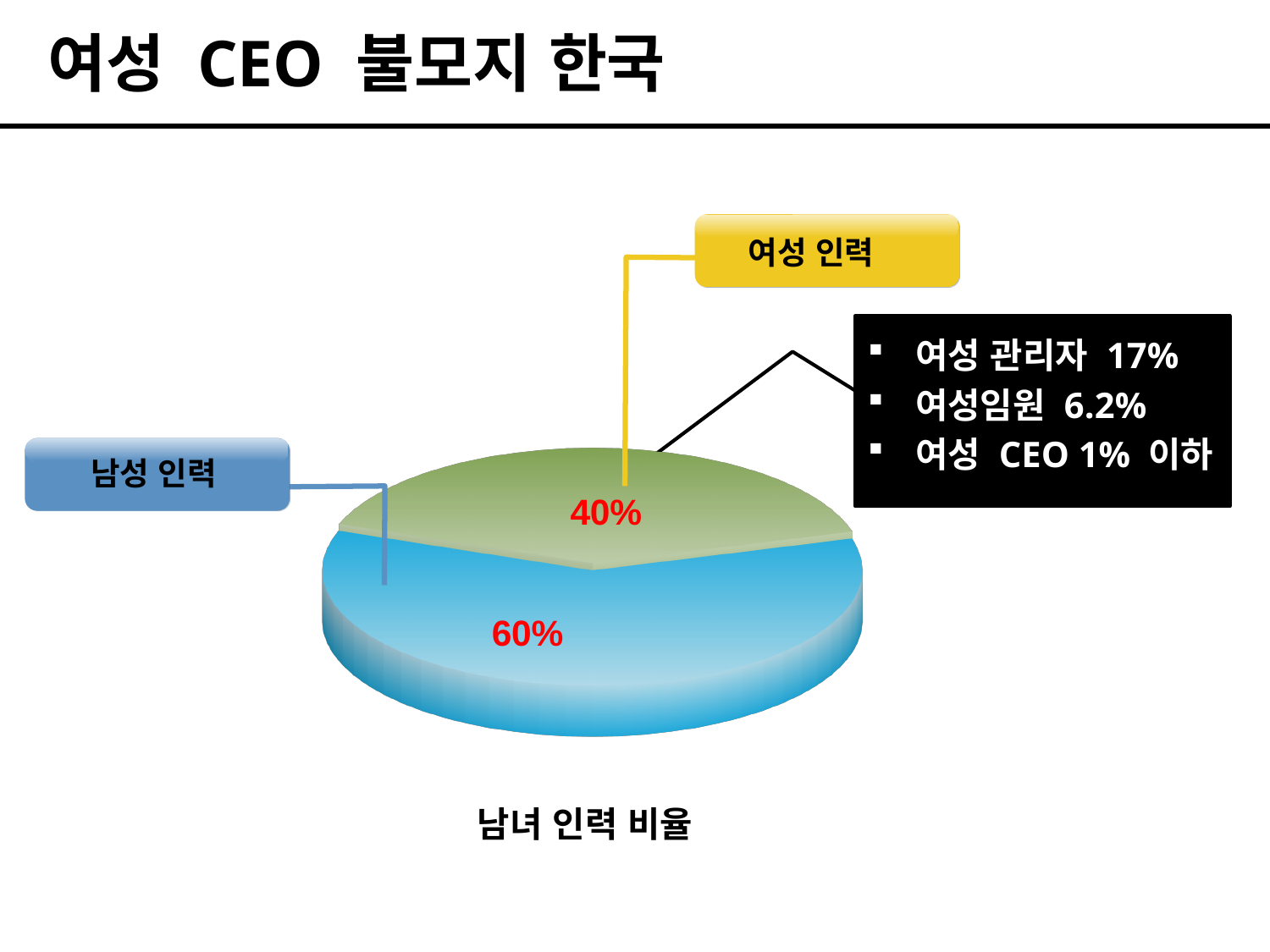
What is the difference between the 남성 인력 and 여성 인력 shares in the pie chart? 20% What share of the pie does the 여성 인력 slice represent? 40% What colour is the 남성 인력 slice in the pie chart? blue Which slice of the pie chart is the smallest? 여성 인력 What is the value for 남성 인력 in the pie chart? 60% What is the title shown below the pie chart? 남녀 인력 비율 Which slice of the pie chart is the largest? 남성 인력 What is the value for 여성 인력 in the pie chart? 40% Which is larger in the pie chart, 남성 인력 or 여성 인력? 남성 인력 How many slices does the pie chart have? 2 What kind of chart is shown on the slide? pie chart